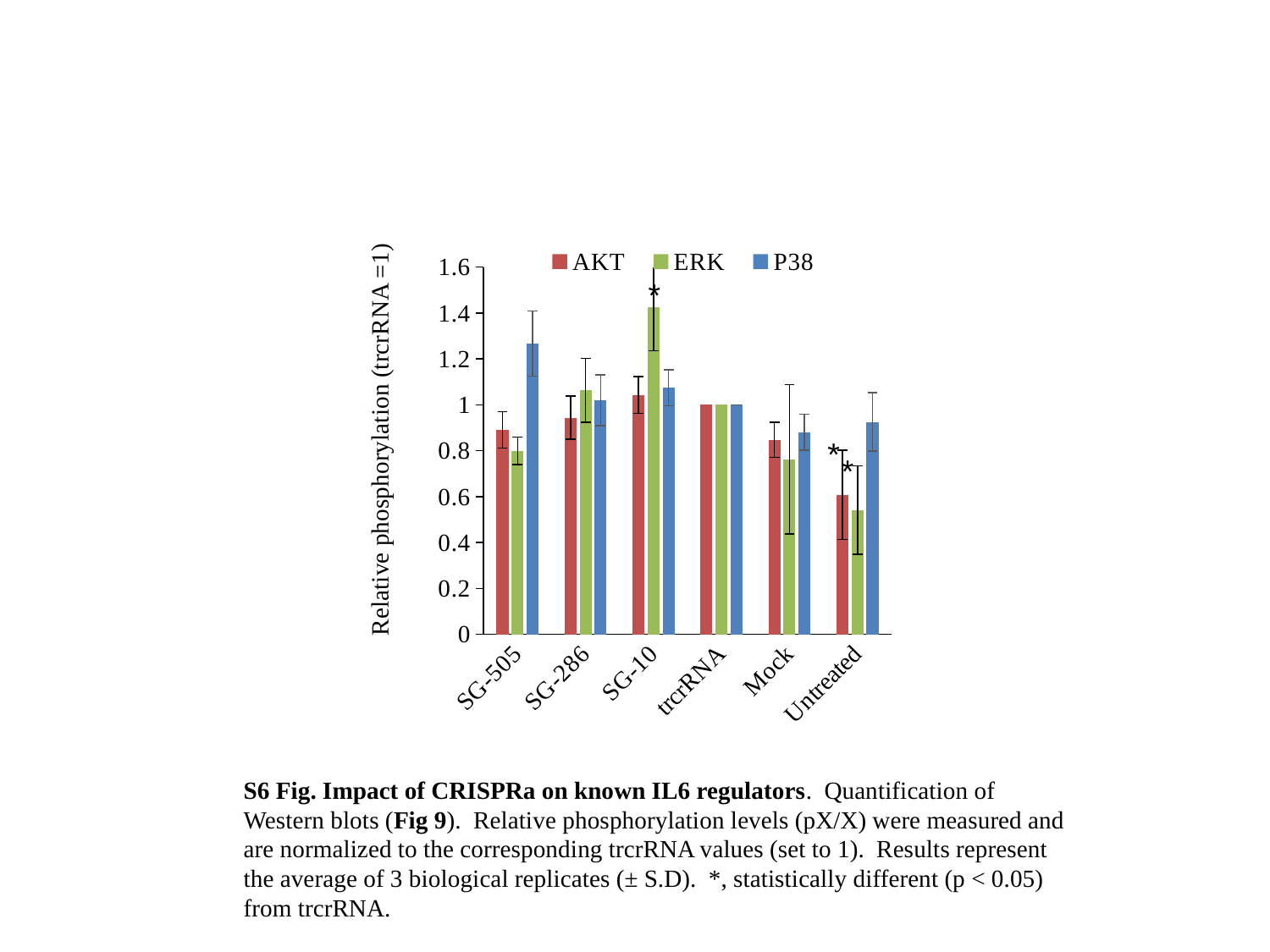
How many series does the legend list? 3 Which category has the highest ERK bar? SG-10 Is the value of ERK for SG-10 greater or less than 1.2? greater What kind of chart is shown on the slide? bar chart Which is larger for Untreated, the P38 bar or the ERK bar? P38 What is the value of AKT for trcrRNA? 1 Which series has the highest bar for SG-505? P38 How many categories are shown on the x axis? 6 Is the value of P38 for SG-505 greater or less than 1? greater Is the value of AKT for Untreated greater or less than 0.8? less What is the y-axis title of the chart? Relative phosphorylation (trcrRNA =1) What is the value of P38 for trcrRNA? 1